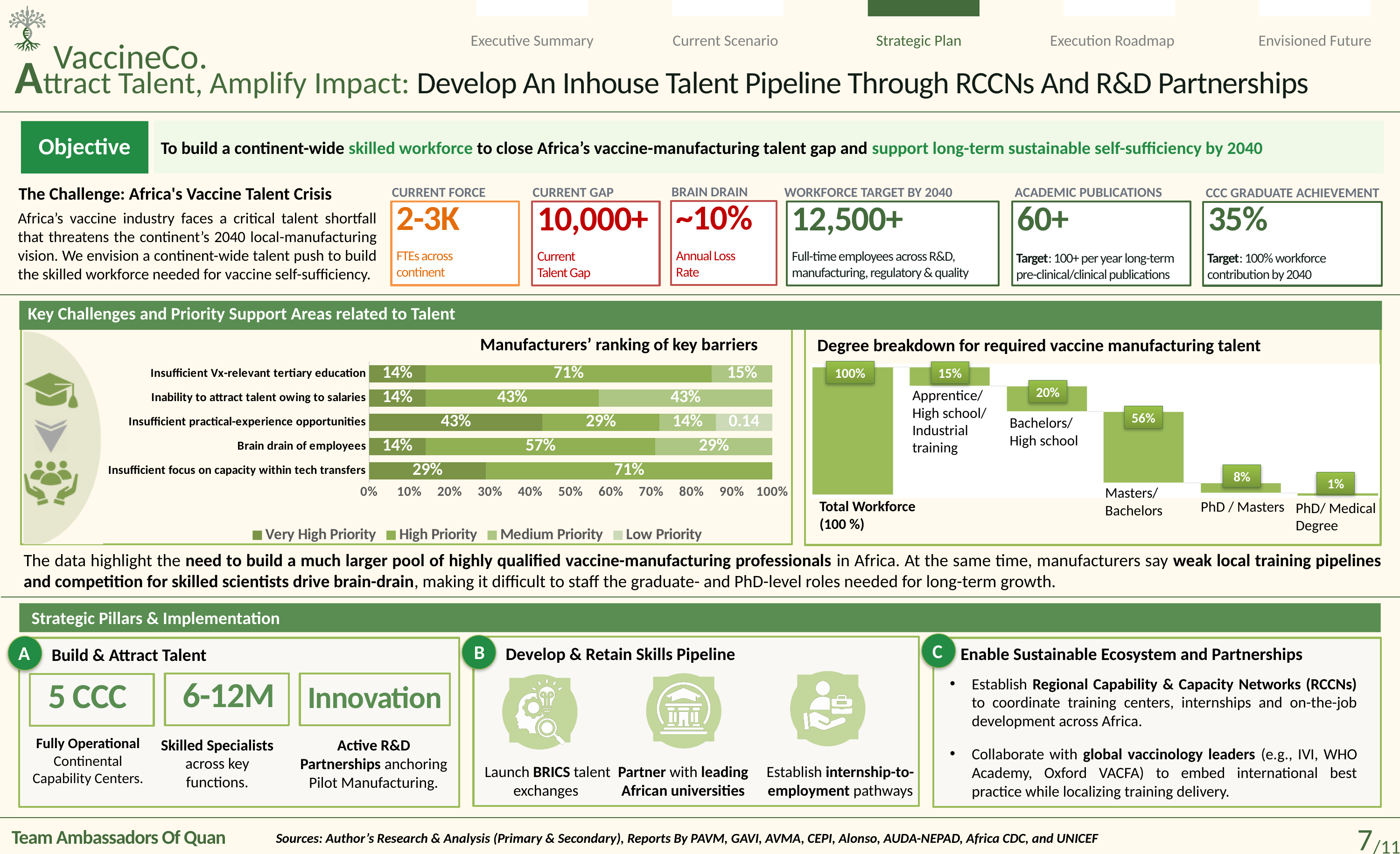
In the 'Degree breakdown for required vaccine manufacturing talent' chart, what share is shown for Masters/Bachelors? 56% In the 'Manufacturers' ranking of key barriers' chart, how many series does the legend list? 4 In the 'Manufacturers' ranking of key barriers' chart, which barrier has the highest Very High Priority share? Insufficient practical-experience opportunities In the 'Manufacturers' ranking of key barriers' chart, what percentage of manufacturers rated 'Brain drain of employees' as High Priority? 57% In the 'Degree breakdown for required vaccine manufacturing talent' chart, which is larger: the share for Bachelors/High school or the share for PhD / Masters? Bachelors/High school In the 'Manufacturers' ranking of key barriers' chart, what is the difference between the High Priority share for 'Insufficient Vx-relevant tertiary education' and the High Priority share for 'Brain drain of employees'? 14% In the 'Manufacturers' ranking of key barriers' chart, how many barriers are listed? 5 In the 'Degree breakdown for required vaccine manufacturing talent' chart, which degree category has the smallest share? PhD/ Medical Degree In the 'Degree breakdown for required vaccine manufacturing talent' chart, what is the difference between the Bachelors/High school share and the Apprentice/High school/Industrial training share? 5% What kind of chart is 'Manufacturers' ranking of key barriers'? Stacked bar chart In the 'Manufacturers' ranking of key barriers' chart, what is the Medium Priority share for 'Inability to attract talent owing to salaries'? 43% In the 'Manufacturers' ranking of key barriers' chart, what is the Very High Priority share for 'Insufficient practical-experience opportunities'? 43%